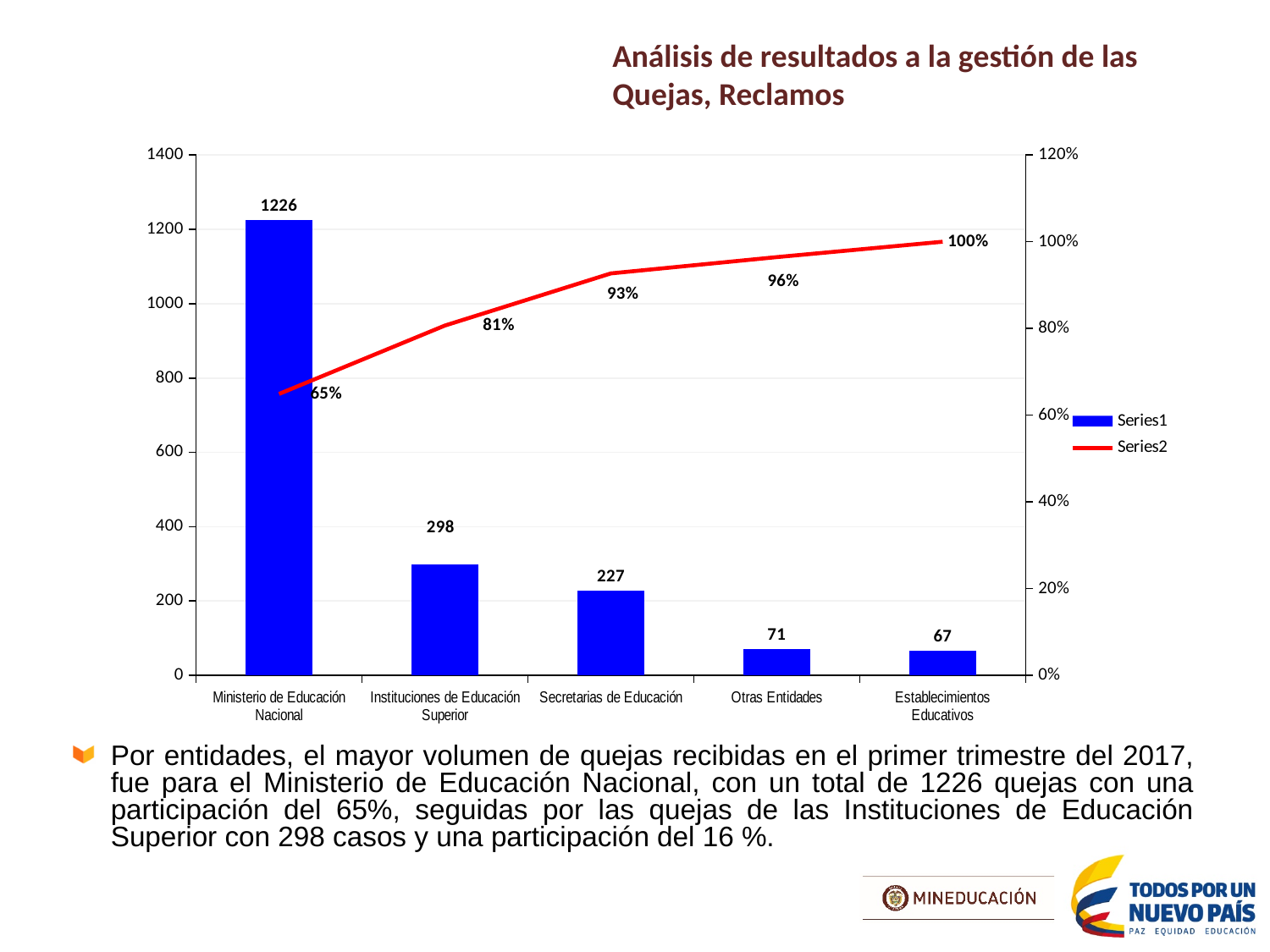
What is the difference between the bar values for Ministerio de Educación Nacional and Instituciones de Educación Superior? 928 What is the value of the bar for Secretarias de Educación? 227 What is the value of the bar for Ministerio de Educación Nacional? 1226 Do the line values rise or fall from left to right along the x axis? rise What is the value of the bar for Instituciones de Educación Superior? 298 Which category has the lowest bar value? Establecimientos Educativos How many categories are shown on the x axis? 5 What cumulative percentage does the line show at Secretarias de Educación? 93% What cumulative percentage does the line show at Establecimientos Educativos? 100% Which category has the highest bar value? Ministerio de Educación Nacional Which has a larger bar value, Secretarias de Educación or Otras Entidades? Secretarias de Educación How many series does the legend list? 2